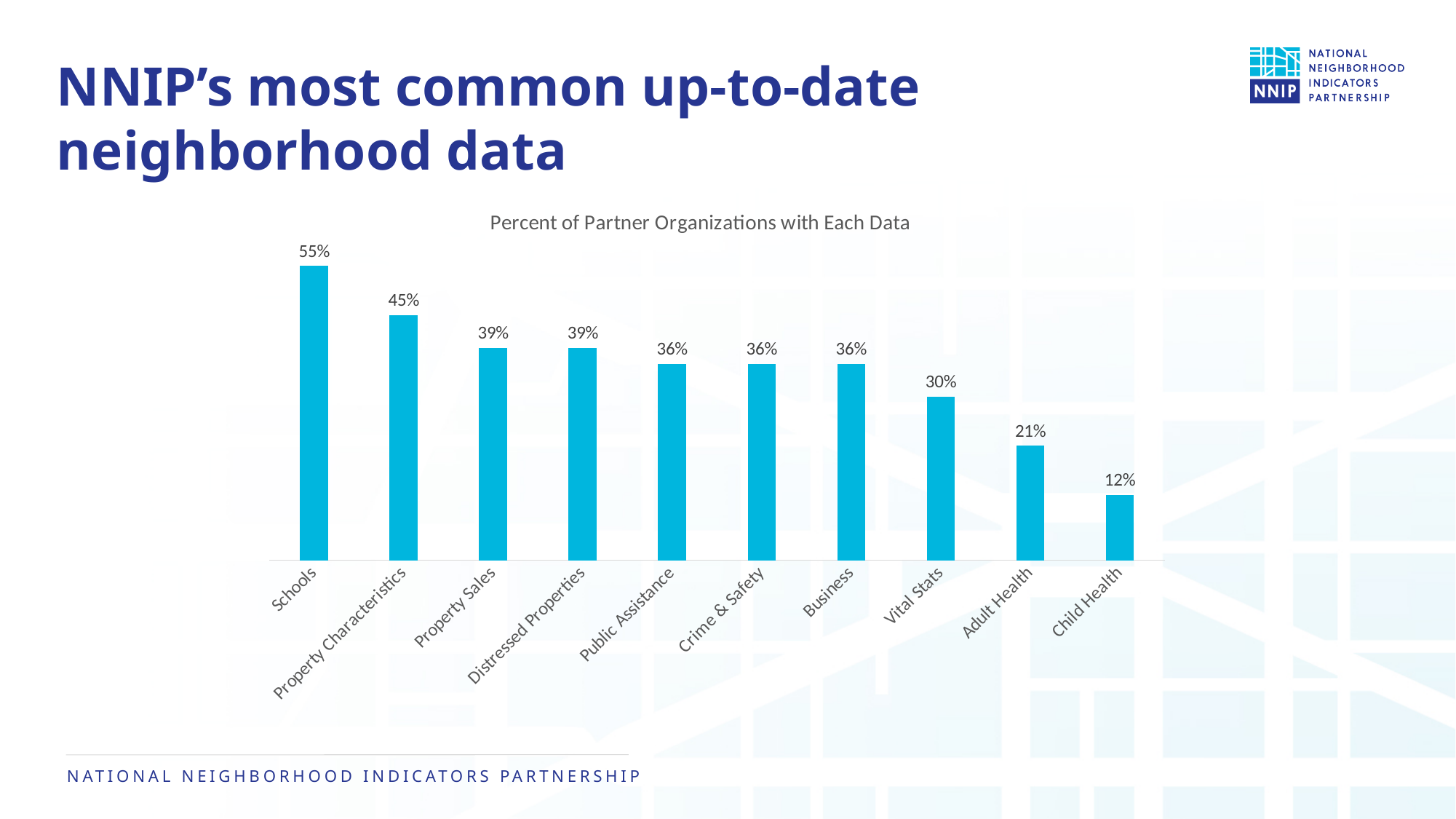
What is the value for Adult Health? 21% Which category has the highest value? Schools Which category has the lowest value? Child Health How many categories are shown in the chart? 10 What is the difference between the values for Schools and Property Characteristics? 10% What is the value for Vital Stats? 30% What is the title of the chart? Percent of Partner Organizations with Each Data Which is larger, the value for Property Sales or the value for Vital Stats? Property Sales What is the difference between the values for Adult Health and Child Health? 9% What kind of chart is shown on the slide? Bar chart Do the values rise or fall from left to right along the x axis? Fall What percent of partner organizations have Schools data? 55%